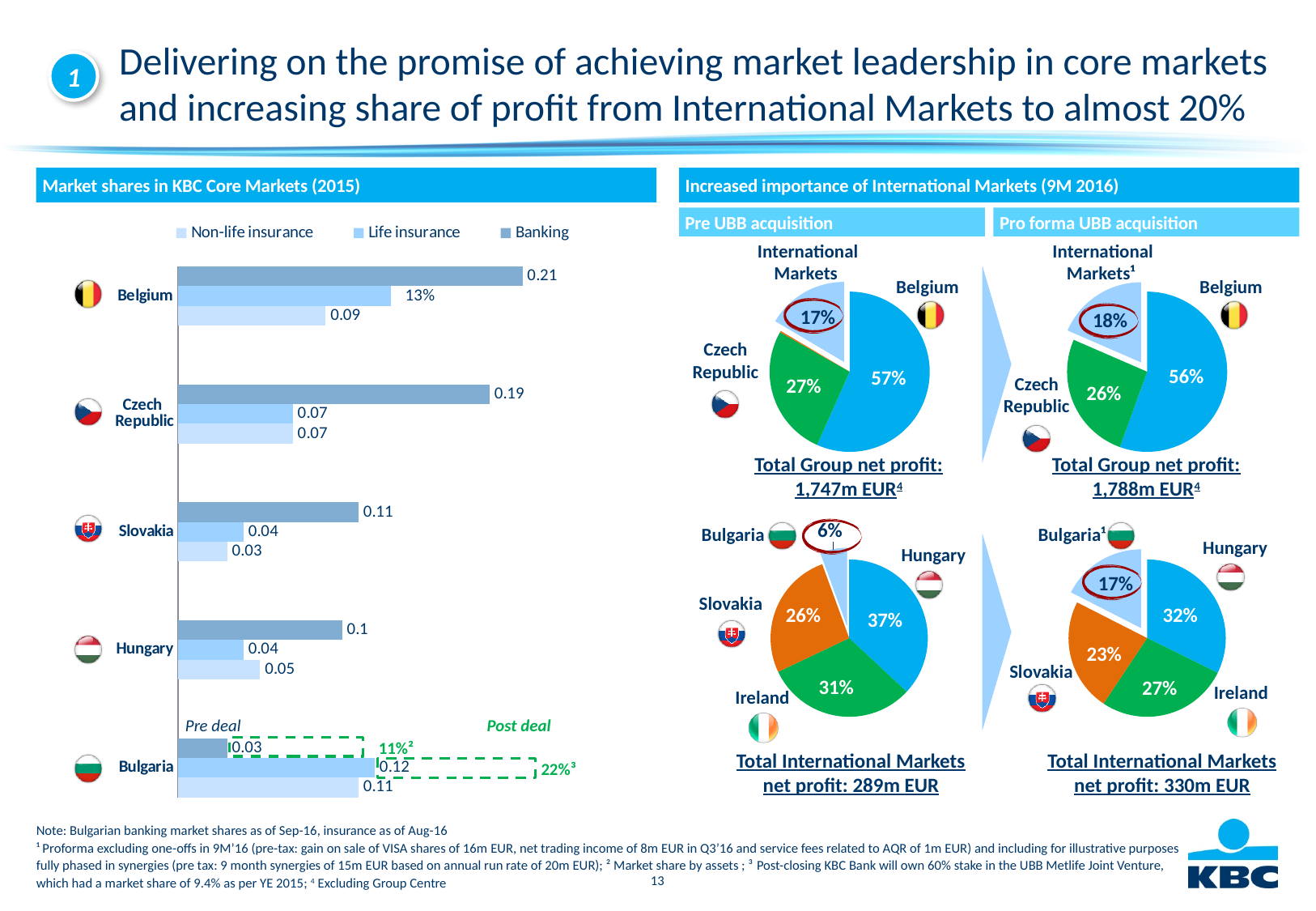
In the 'Pre UBB acquisition' Total International Markets net profit pie chart, which country has the smallest share? Bulgaria In the 'Pro forma UBB acquisition' Total Group net profit pie chart, what share do International Markets have? 18% In the 'Market shares in KBC Core Markets (2015)' bar chart, how many series does the legend list? 3 In the 'Market shares in KBC Core Markets (2015)' bar chart, which country has the lowest Banking value? Bulgaria In the 'Market shares in KBC Core Markets (2015)' bar chart, what is the Life insurance value for Bulgaria? 0.12 In the 'Market shares in KBC Core Markets (2015)' bar chart, what is the Banking value for Belgium? 0.21 In the 'Pro forma UBB acquisition' Total International Markets net profit pie chart, which is larger, the share for Slovakia or the share for Ireland? Ireland What type of chart is used for 'Market shares in KBC Core Markets (2015)'? Bar chart In the 'Market shares in KBC Core Markets (2015)' bar chart, how many countries are shown? 5 In the 'Market shares in KBC Core Markets (2015)' bar chart, which country has the highest Banking value? Belgium In the 'Market shares in KBC Core Markets (2015)' bar chart, what is the difference between the Banking values for Czech Republic and Slovakia? 0.08 In the 'Pre UBB acquisition' Total Group net profit pie chart, what share does Belgium have? 57%